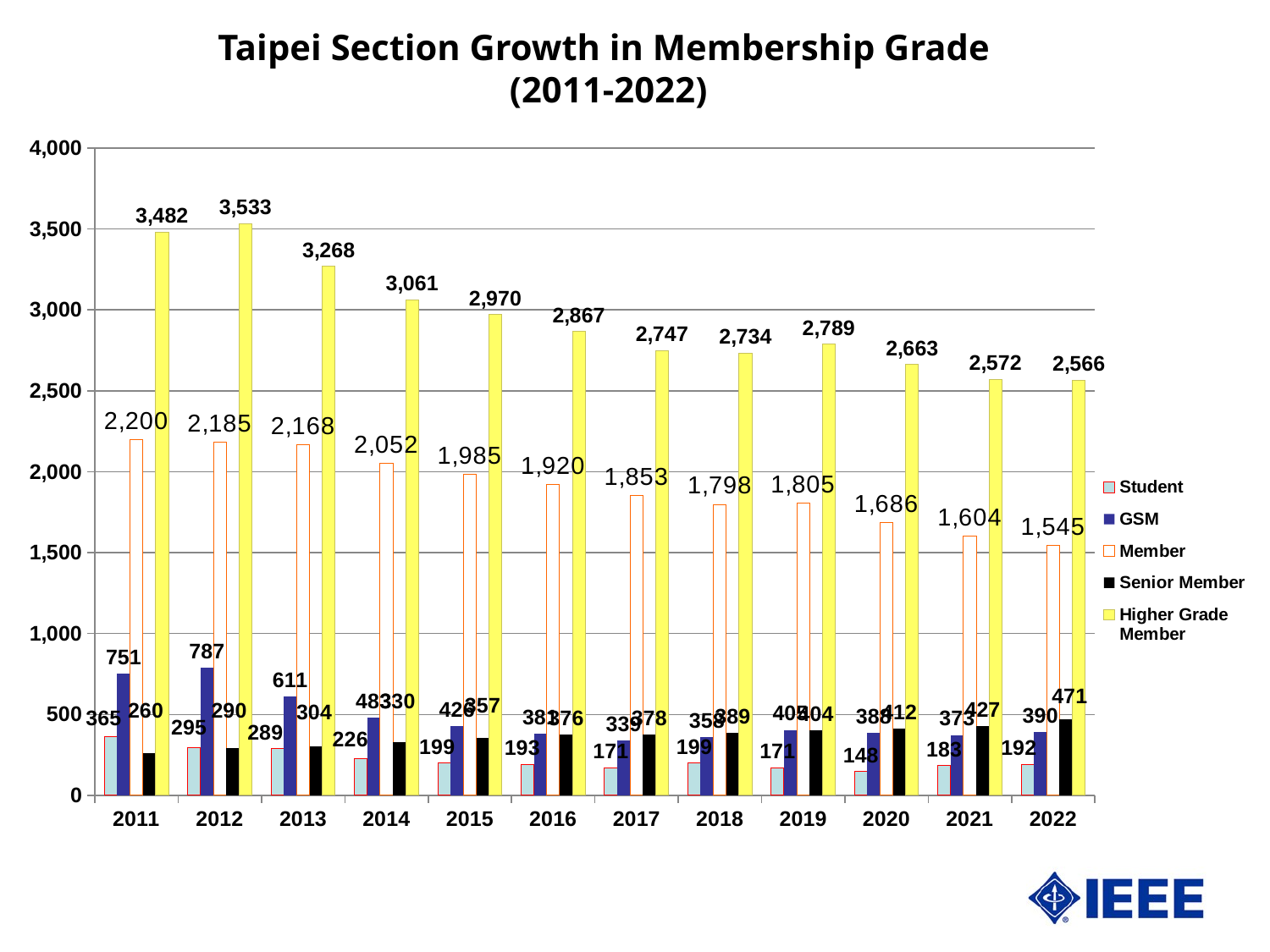
What is the difference between the Higher Grade Member values in 2011 and 2022? 916 Is the value for Senior Member in 2011 greater or less than 500? less What is the value for Student in 2020? 148 In which year is the Higher Grade Member value highest? 2012 Does the Member value rise or fall from 2011 to 2022? fall What is the value for Higher Grade Member in 2012? 3,533 How many series does the legend list? 5 Which is larger in 2011, the Student value or the GSM value? GSM What kind of chart is shown on the slide? bar chart In which year is the Member value lowest? 2022 How many years are shown on the x axis? 12 What is the value for Member in 2022? 1,545